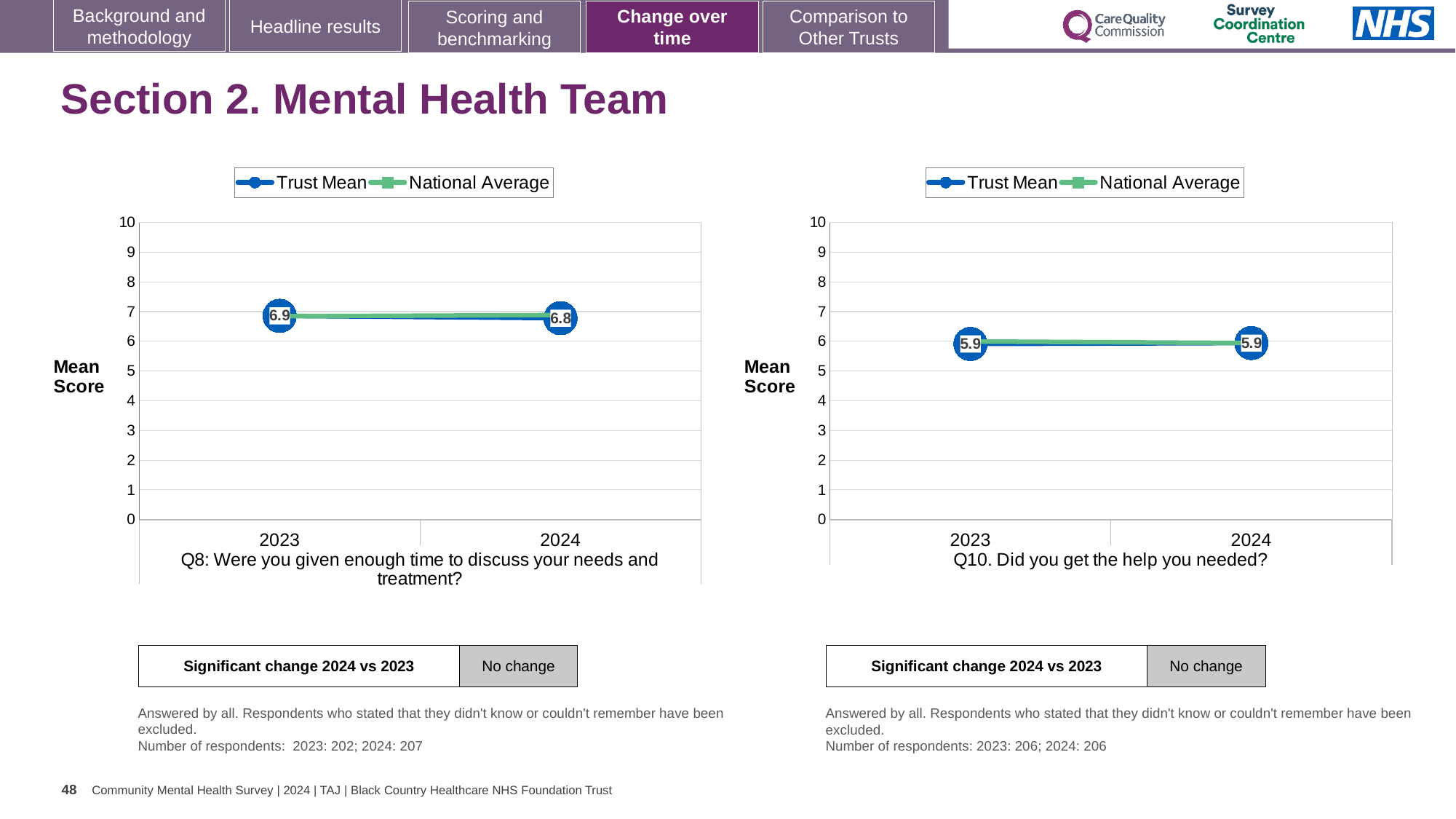
In the Q8 chart (left), is the Trust Mean for 2024 greater or less than 7? less In the Q10 chart (right), is the Trust Mean for 2023 greater or less than 5? greater In the Q8 chart (left), what is the Trust Mean for 2023? 6.9 In the Q8 chart (left), what is the Trust Mean for 2024? 6.8 What is the y-axis label of the Q8 chart (left)? Mean Score In the Q8 chart (left), what is the difference between the Trust Mean for 2023 and 2024? 0.1 What kind of chart is the Q10 chart (right)? line chart In the Q10 chart (right), what is the Trust Mean for 2024? 5.9 How many series does the legend of the Q10 chart (right) list? 2 How many years are plotted on the x axis of the Q8 chart (left)? 2 In the Q10 chart (right), what is the Trust Mean for 2023? 5.9 In the Q8 chart (left), does the Trust Mean rise or fall from 2023 to 2024? fall